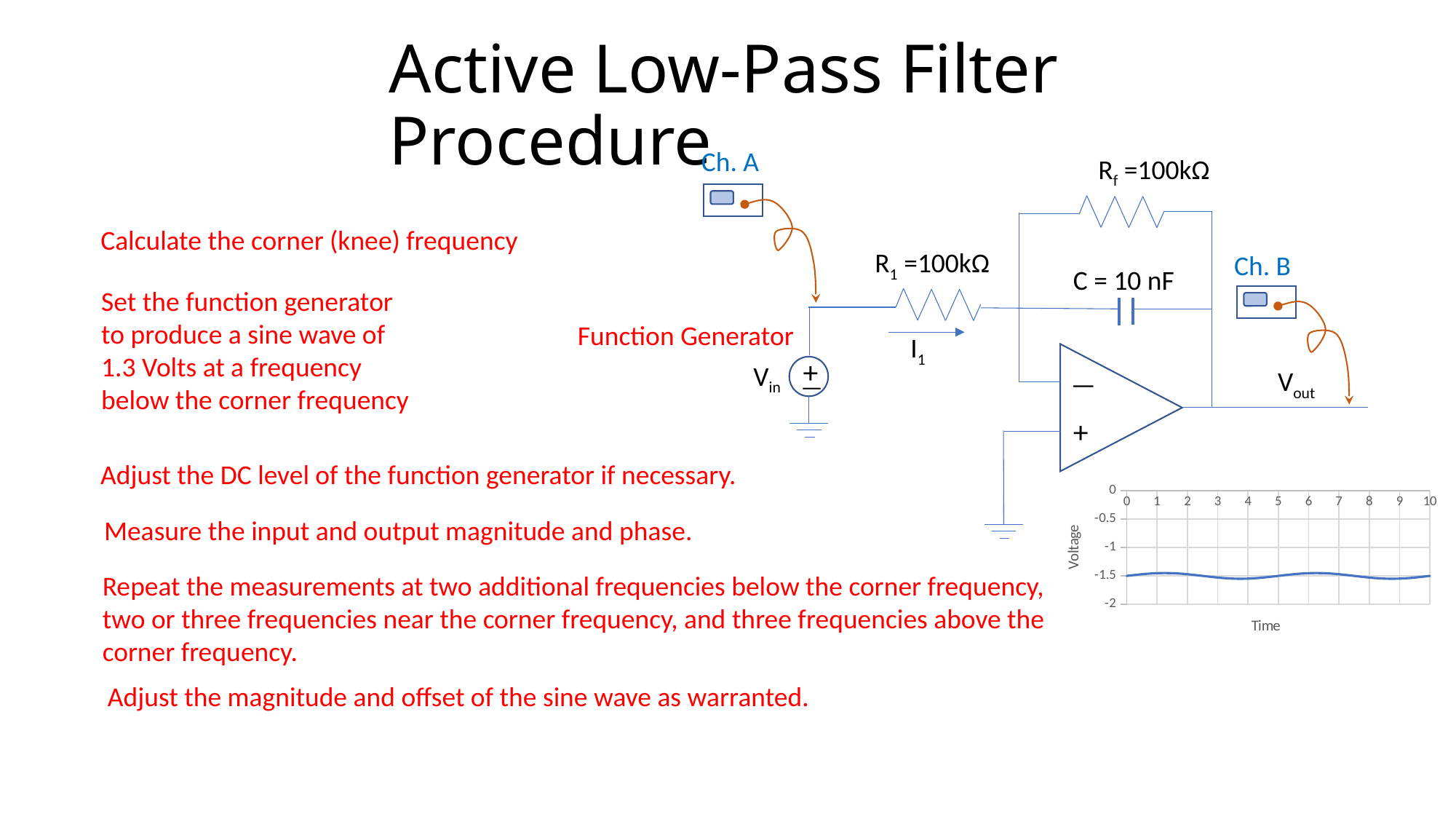
What is the lowest value labelled on the Voltage axis of the chart? -2 What kind of chart is shown at the bottom right of the slide? line chart What is the label on the vertical axis of the chart? Voltage What is the label on the horizontal axis of the chart? Time Is the voltage value at time 0 greater or less than -1? less How many tick marks are labelled on the Time axis of the chart? 11 Is the voltage value at time 5 greater or less than -2? greater Is the voltage value at time 2 greater or less than -0.5? less